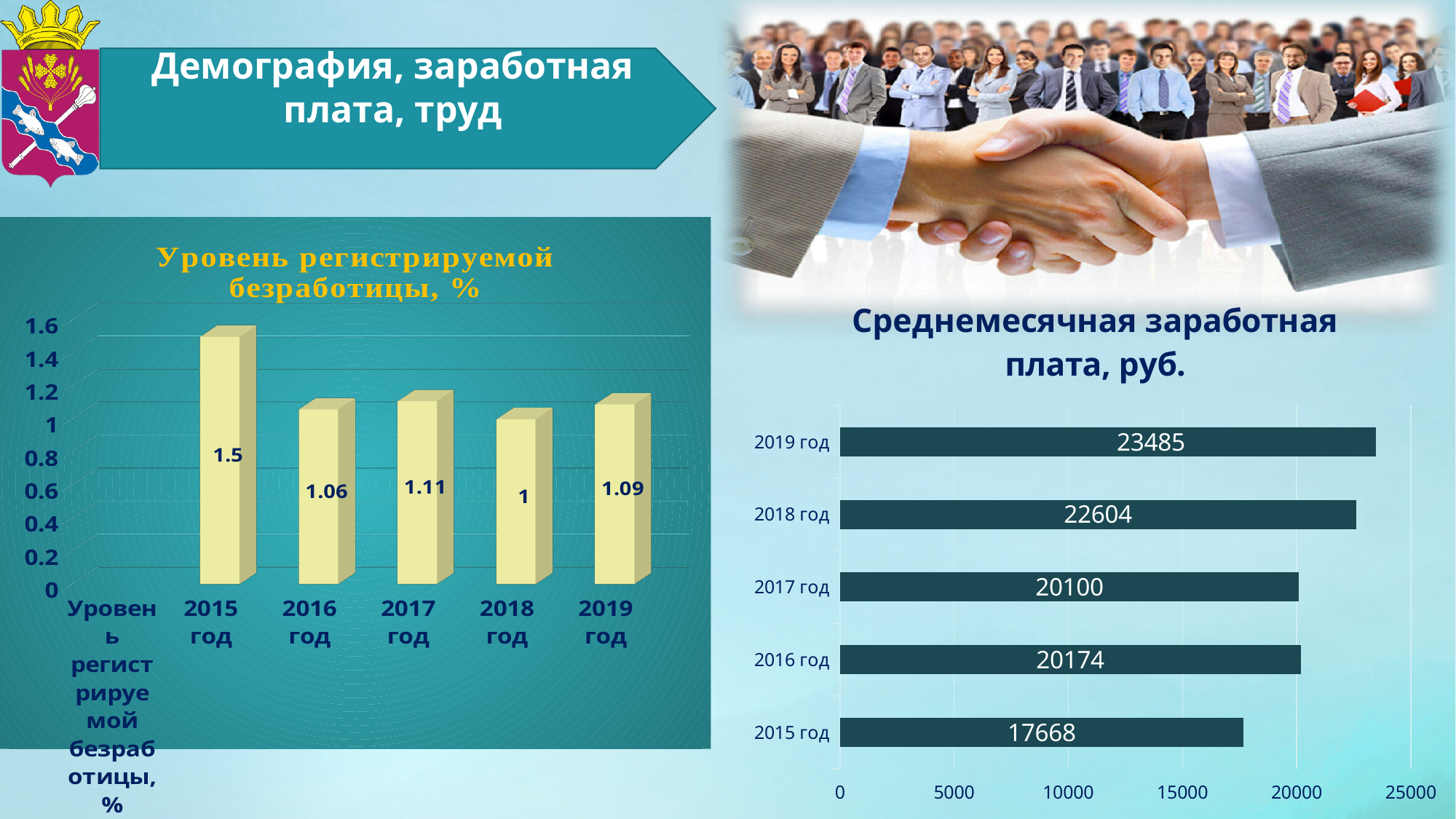
In the chart 'Среднемесячная заработная плата, руб.', which year has the highest value? 2019 год In the chart 'Уровень регистрируемой безработицы, %', what is the value for 2015 год? 1.5 In the chart 'Уровень регистрируемой безработицы, %', which year has the highest value? 2015 год In the chart 'Уровень регистрируемой безработицы, %', which is larger, the value for 2017 год or 2019 год? 2017 год In the chart 'Среднемесячная заработная плата, руб.', what is the value for 2015 год? 17668 In the chart 'Среднемесячная заработная плата, руб.', what is the value for 2017 год? 20100 What kind of chart is 'Среднемесячная заработная плата, руб.'? Bar chart In the chart 'Среднемесячная заработная плата, руб.', how many years are shown? 5 In the chart 'Уровень регистрируемой безработицы, %', which year has the lowest value? 2018 год In the chart 'Уровень регистрируемой безработицы, %', what is the difference between the values for 2015 год and 2016 год? 0.44 In the chart 'Уровень регистрируемой безработицы, %', what is the value for 2018 год? 1 In the chart 'Среднемесячная заработная плата, руб.', what is the difference between the values for 2019 год and 2018 год? 881